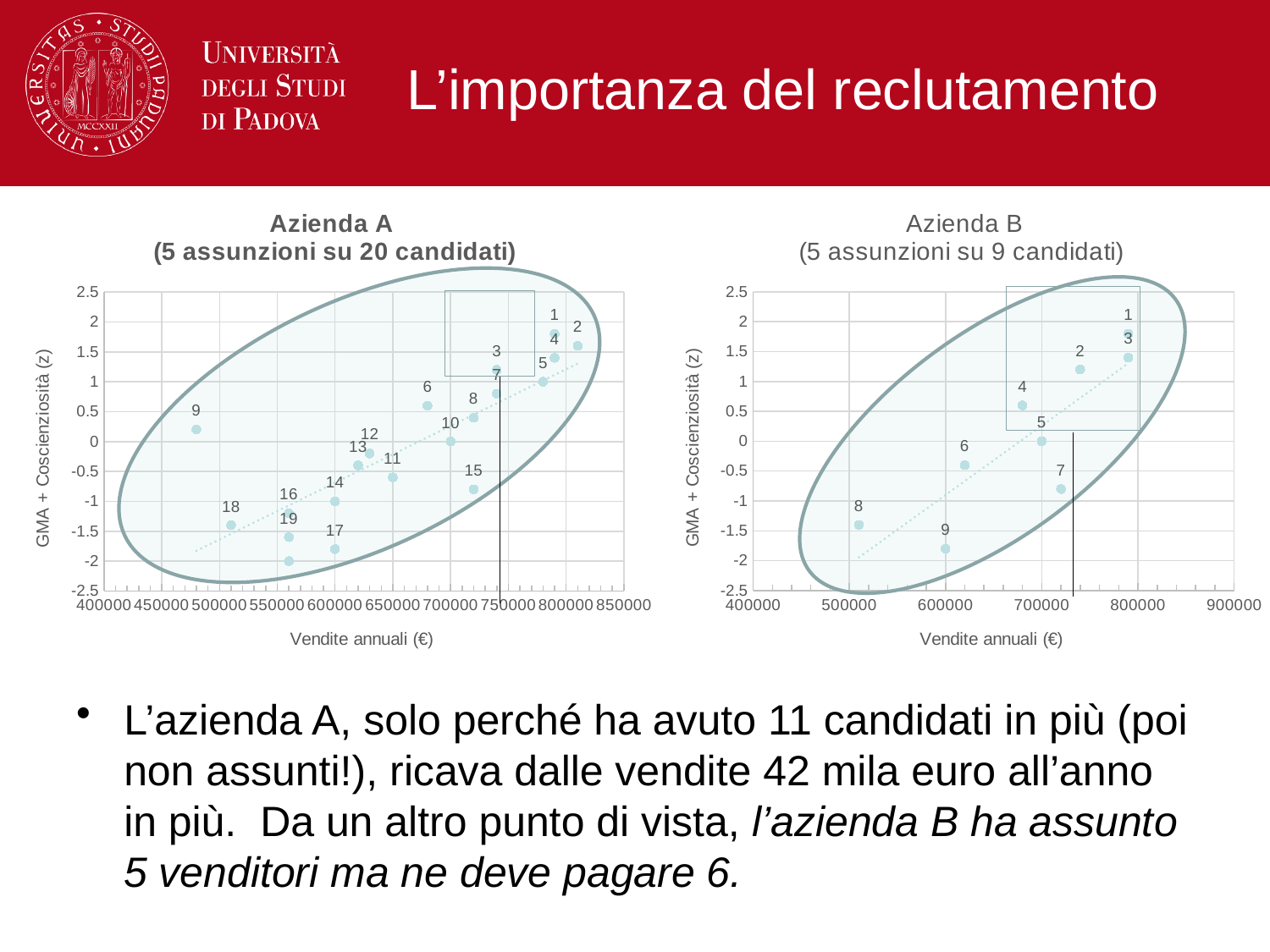
In the "Azienda A" chart, which point has the lowest annual sales (Vendite annuali)? 9 In the "Azienda A" chart, are the annual sales for point 9 greater or less than 500000? less In the "Azienda A" chart, which point has higher annual sales, point 1 or point 2? 2 In the "Azienda B" chart, are the annual sales for point 8 greater or less than 600000? less In the "Azienda B" chart, is the GMA + Coscienziosità value for point 1 greater or less than 1.5? greater In the "Azienda A" chart, which point has the highest GMA + Coscienziosità value? 1 What kind of chart is the "Azienda A" chart? Scatter chart In the "Azienda B" chart, which point has the lowest GMA + Coscienziosità value? 9 What is the label of the vertical axis in the "Azienda B" chart? GMA + Coscienziosità (z) How many data points are plotted in the "Azienda B" chart? 9 How many data points are plotted in the "Azienda A" chart? 20 In the "Azienda B" chart, which point has the highest GMA + Coscienziosità value? 1